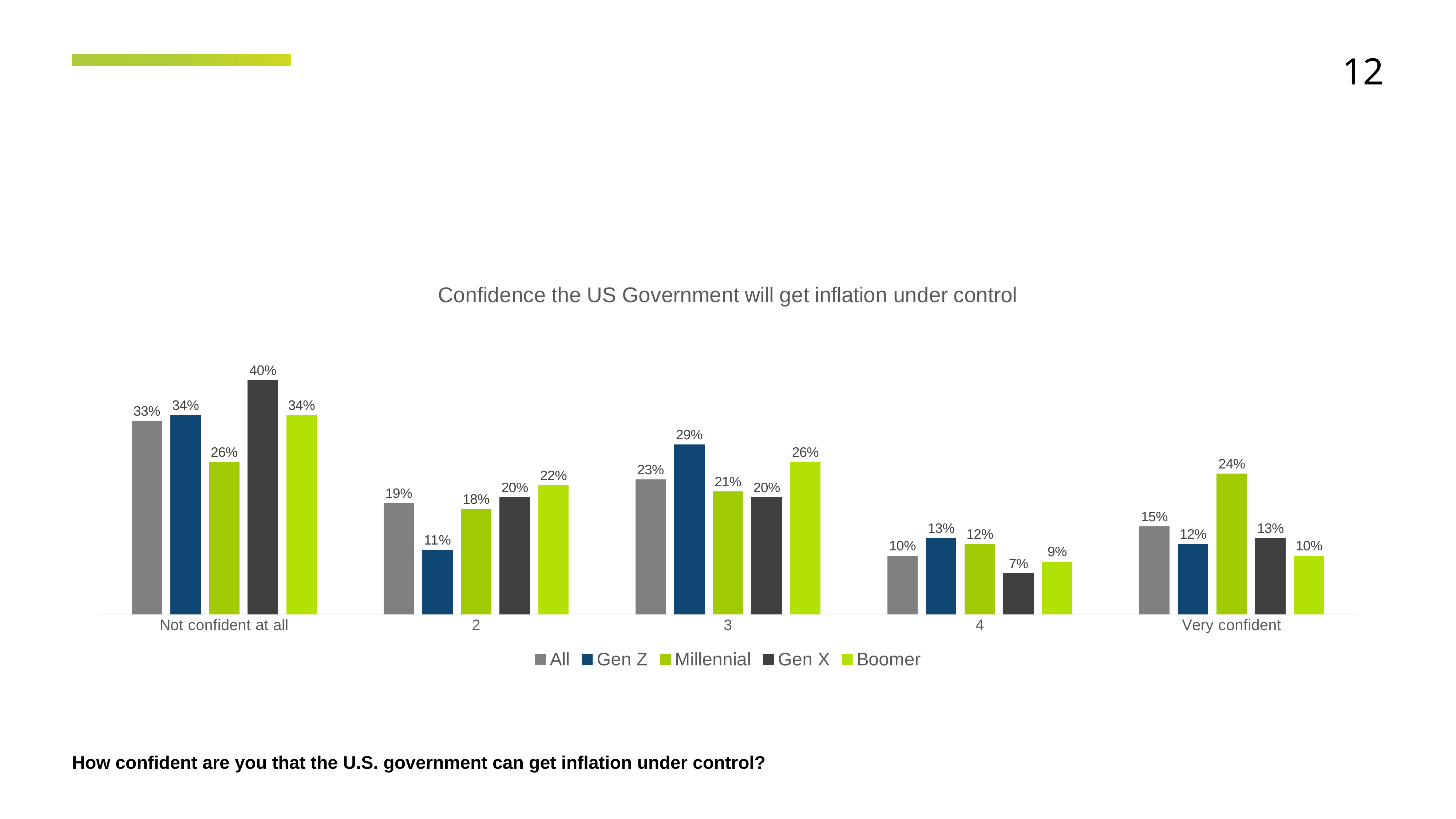
What kind of chart is shown on the slide? Bar chart How many series does the legend list? 5 What is the title of the chart? Confidence the US Government will get inflation under control What is the value for Millennial in the 'Very confident' category? 24% What is the difference between the Gen X and Millennial values in the 'Not confident at all' category? 14% What is the value for Gen Z in category 3? 29% Which series has the highest value in the 'Not confident at all' category? Gen X What is the value for Gen X in the 'Not confident at all' category? 40% Which is larger in category 2: the value for Boomer or the value for Gen Z? Boomer How many categories are shown on the x axis? 5 Does the value for the 'All' series rise or fall from 'Not confident at all' to 'Very confident'? Fall Which series has the lowest value in category 4? Gen X